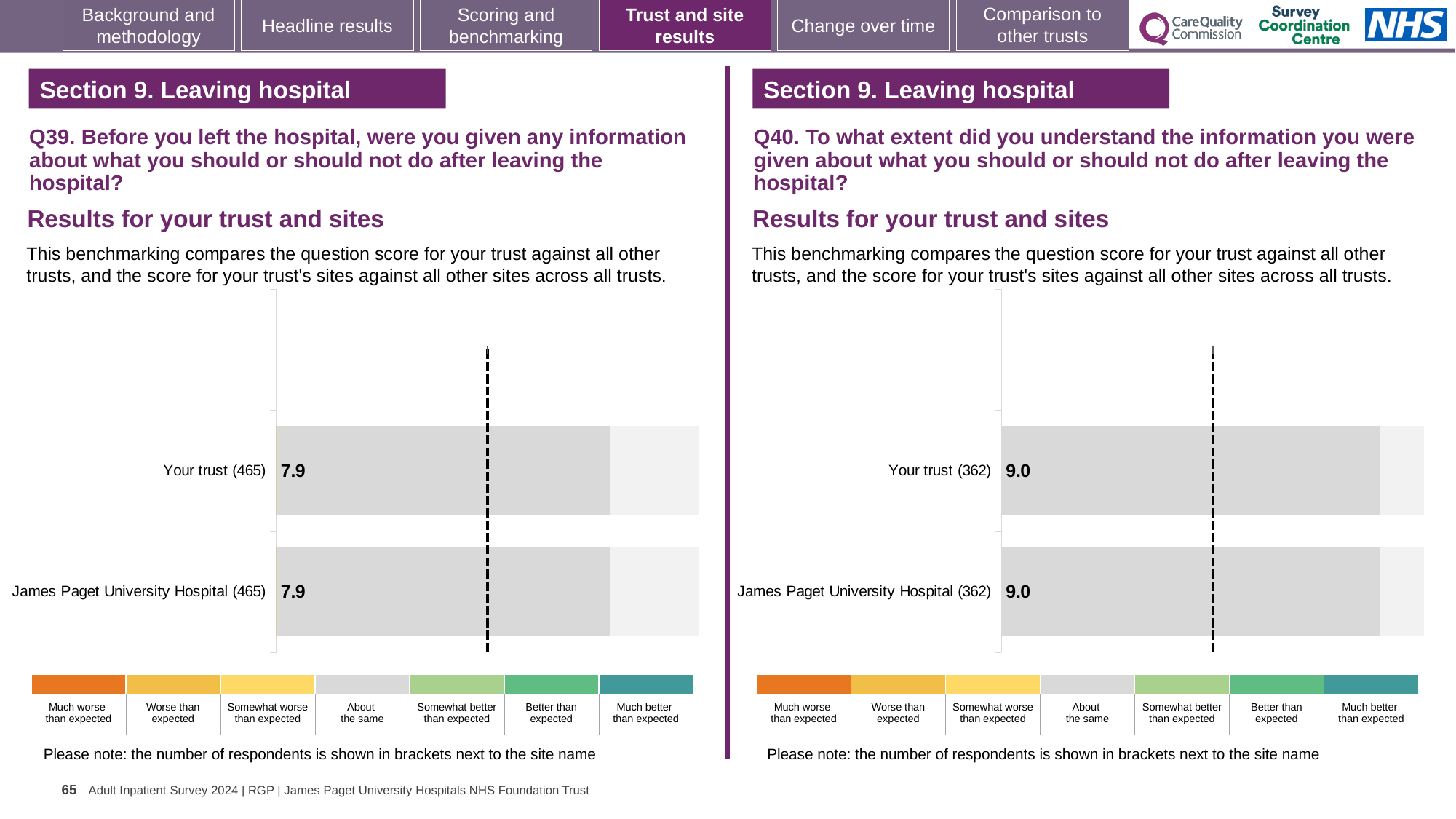
In the Q40 chart on the right, what is the score for James Paget University Hospital? 9.0 In the Q40 chart on the right, how many respondents are shown in brackets next to James Paget University Hospital? 362 Is the score for Your trust in the Q40 chart on the right larger than the score for Your trust in the Q39 chart on the left? Yes In the Q40 chart on the right, what is the score for Your trust? 9.0 In the Q39 chart on the left, how many respondents are shown in brackets next to Your trust? 465 How many bars are plotted in the Q40 chart on the right? 2 In the Q39 chart on the left, what is the score for James Paget University Hospital? 7.9 In the Q40 chart on the right, what is the difference between the score for Your trust and the score for James Paget University Hospital? 0.0 What kind of chart is used for the Q39 results on the left? Bar chart In the Q39 chart on the left, what is the difference between the score for Your trust and the score for James Paget University Hospital? 0.0 In the Q39 chart on the left, what is the score for Your trust? 7.9 How many bars are plotted in the Q39 chart on the left? 2